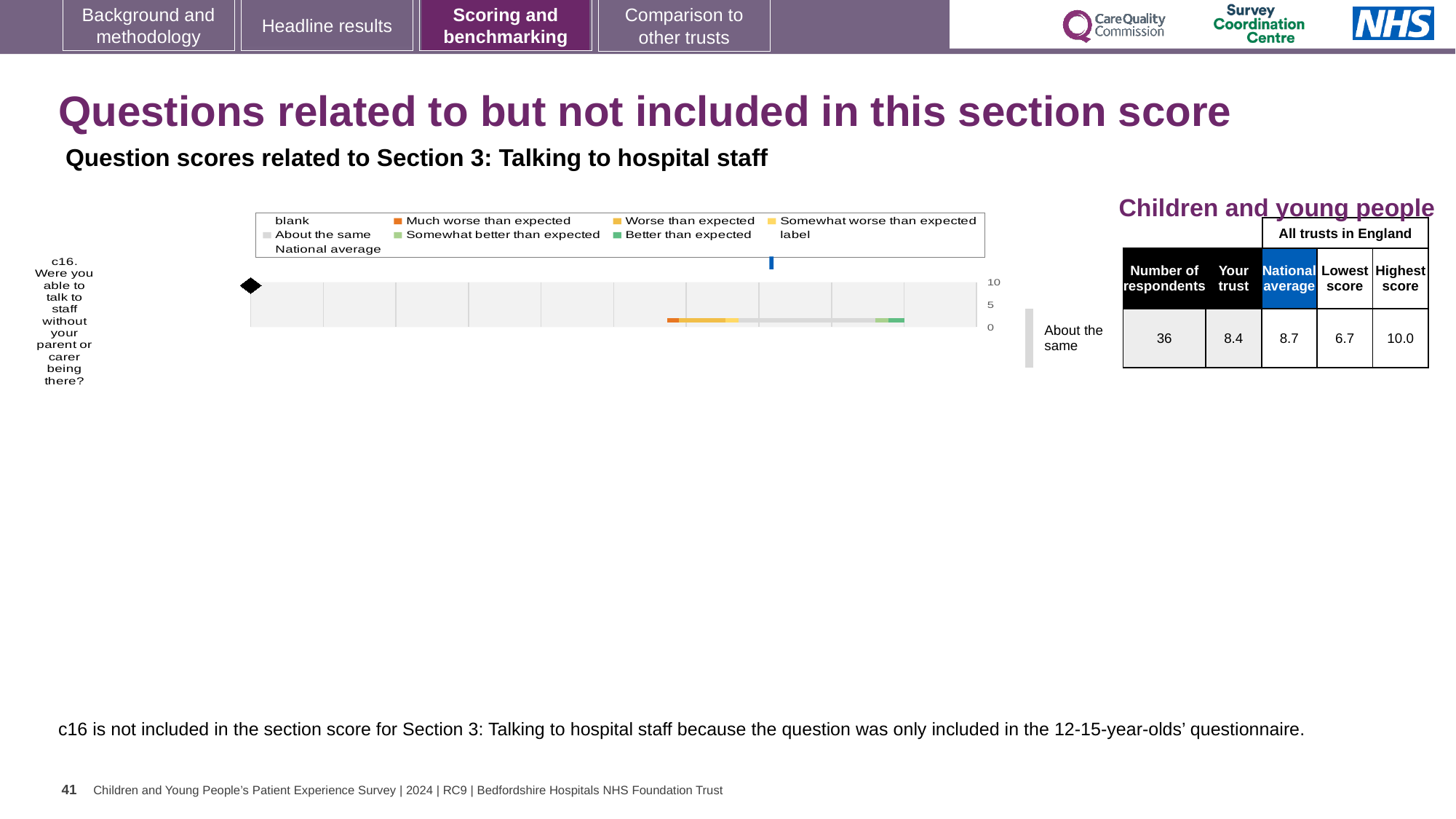
How many questions (categories) are plotted on the chart? 1 In the table next to the chart, what is the Highest score among all trusts in England for c16? 10.0 What is the highest tick value shown on the chart's axis? 10 In the table next to the chart, what is the number of respondents for c16? 36 In the table next to the chart, what is the National average score for c16? 8.7 In the table next to the chart, what is the Lowest score among all trusts in England for c16? 6.7 What benchmark category label is shown to the right of the c16 bar? About the same What is the difference between the National average (8.7) and the 'Your trust' score (8.4) for c16? 0.3 Which question number is plotted on the chart? c16 Which is larger for c16: the 'Your trust' score or the National average? National average What kind of chart is shown on the slide? bar chart In the table next to the chart, what is the 'Your trust' score for c16? 8.4